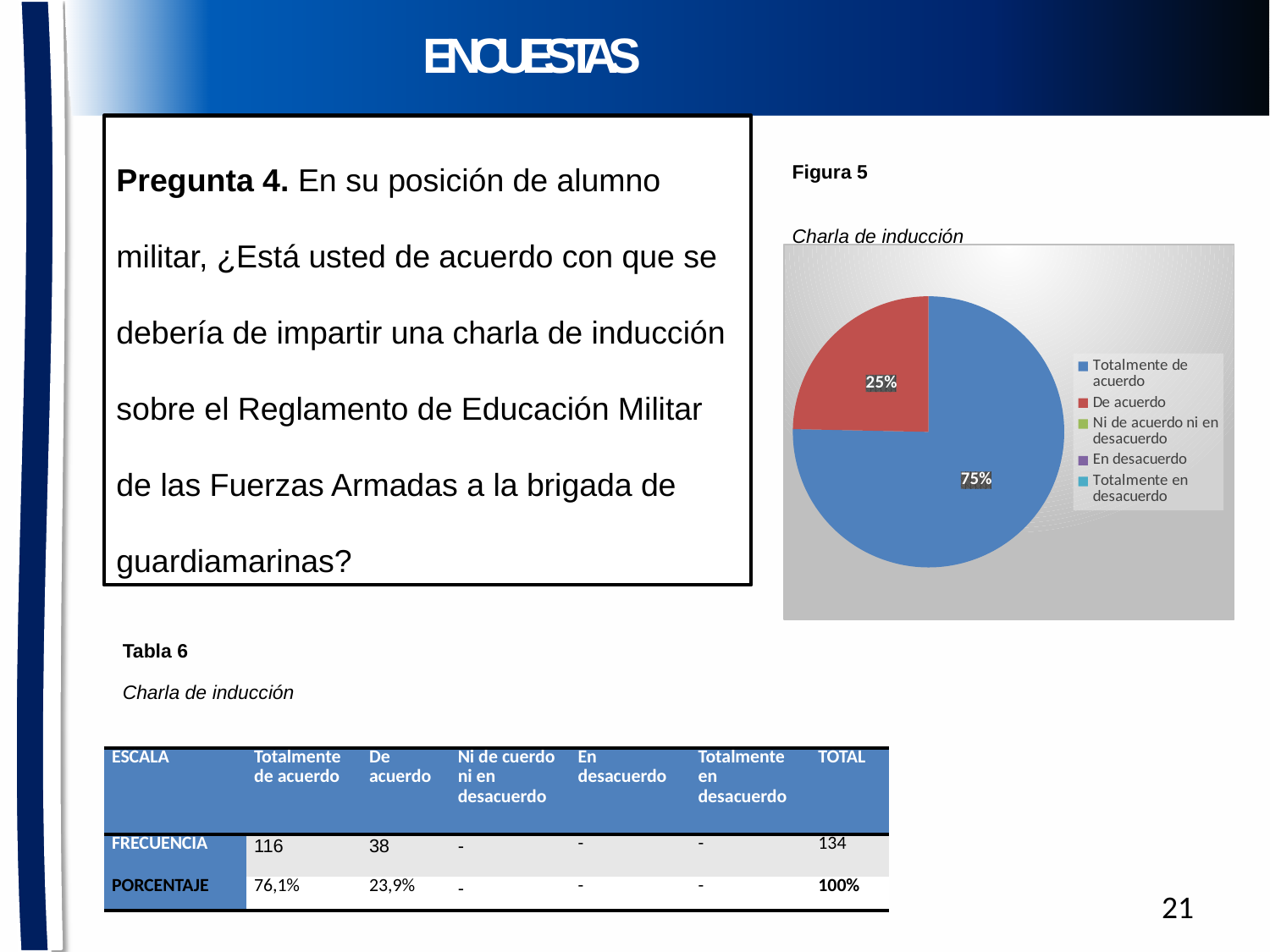
In the pie chart, what share is labelled for the 'Totalmente de acuerdo' slice? 75% Which slice of the pie chart is the largest? Totalmente de acuerdo Which is larger in the pie chart: the 'Totalmente de acuerdo' slice or the 'De acuerdo' slice? Totalmente de acuerdo How many entries does the legend of the pie chart list? 5 How many slices with data labels are visible in the pie chart? 2 What colour is the 'De acuerdo' slice in the pie chart? red What kind of chart is shown in Figura 5? pie chart In the pie chart, what share is labelled for the 'De acuerdo' slice? 25% What is the difference in percentage points between the 'Totalmente de acuerdo' slice and the 'De acuerdo' slice in the pie chart? 50 percentage points Which of the two visible slices in the pie chart is the smallest? De acuerdo What is the title of the pie chart in Figura 5? Charla de inducción